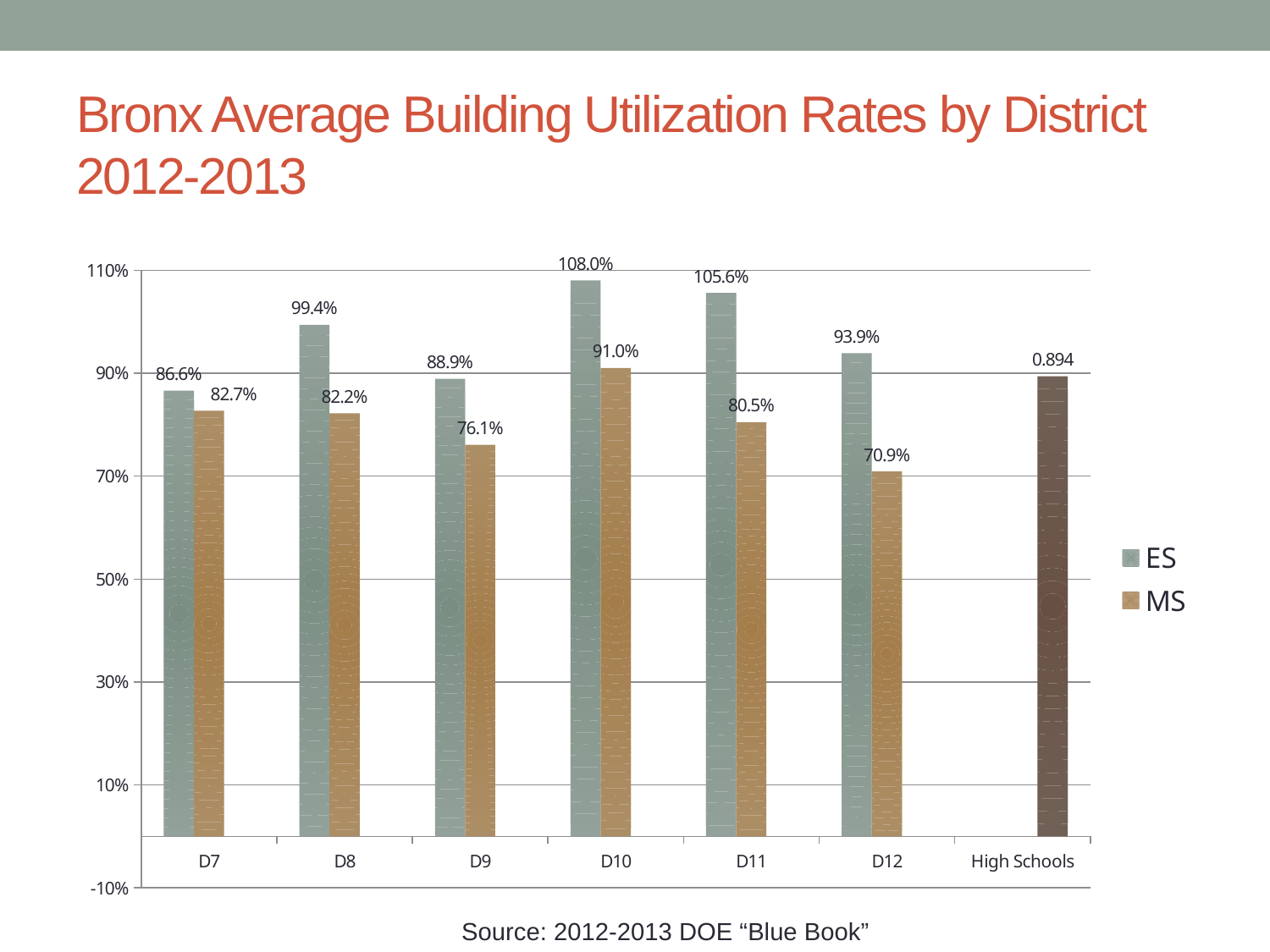
What is the ES utilization rate for D10? 108.0% What is the source cited below the chart? 2012-2013 DOE "Blue Book" What is the MS utilization rate for D9? 76.1% Is the ES value for D11 greater or less than 90%? greater Which is larger, the MS rate for D7 or the MS rate for D8? D7 (82.7%) What kind of chart is shown on the slide? Bar chart Which district has the lowest MS utilization rate? D12 What value is labeled on the High Schools bar? 0.894 How many categories are shown on the x axis? 7 How many series does the legend list? 2 Which district has the highest ES utilization rate? D10 What is the difference between the ES and MS rates for D12? 23.0%